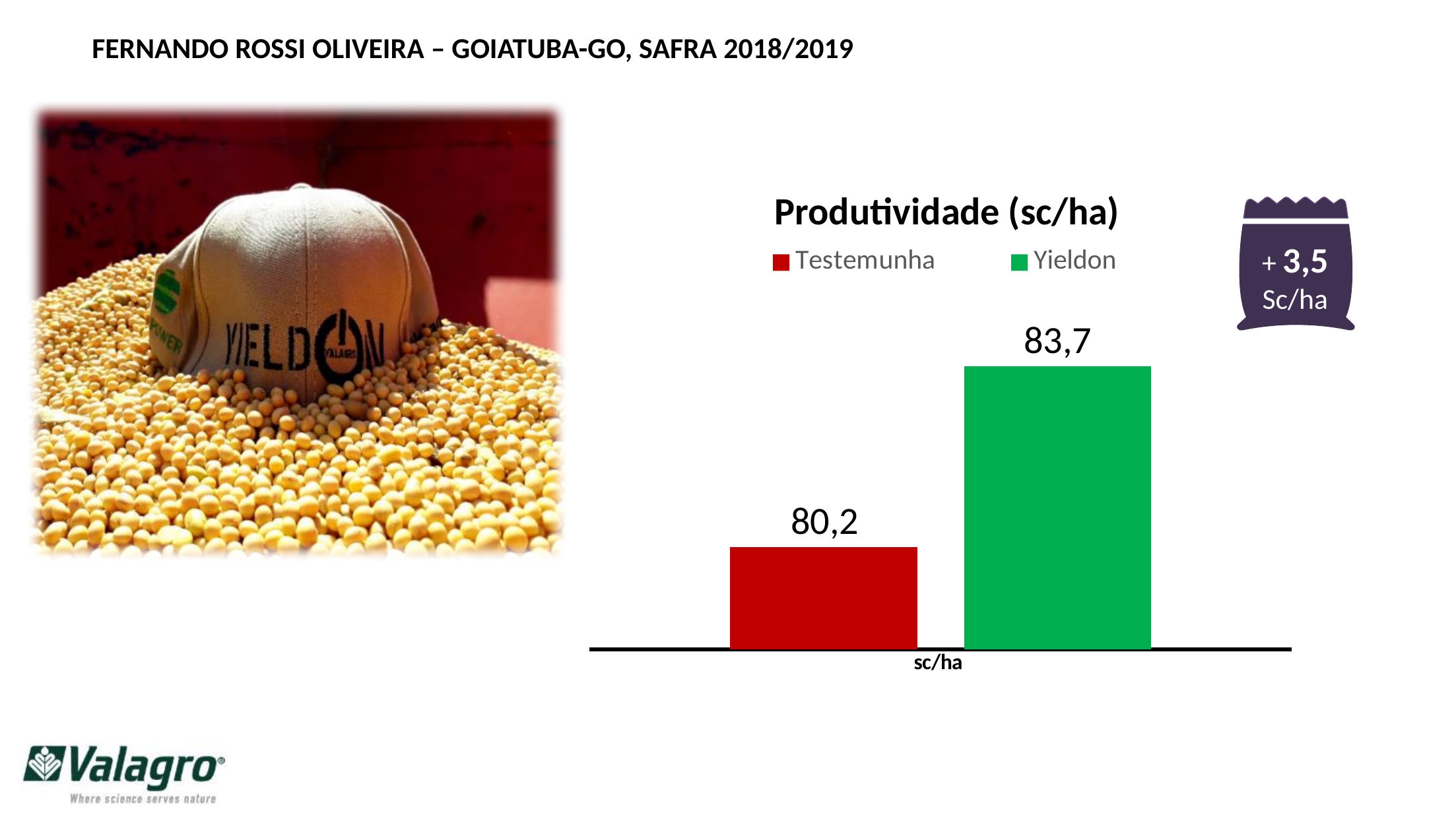
How many series does the legend list? 2 What kind of chart is shown? bar chart How many bars are plotted in the chart? 2 What is the difference between the Yieldon and Testemunha values? 3,5 Which is larger, the value for Testemunha or the value for Yieldon? Yieldon Which series has the highest value? Yieldon What is the title of the chart? Produtividade (sc/ha) What colour is the Yieldon bar? green Which series has the lowest value? Testemunha What is the value for Testemunha? 80,2 What is the value for Yieldon? 83,7